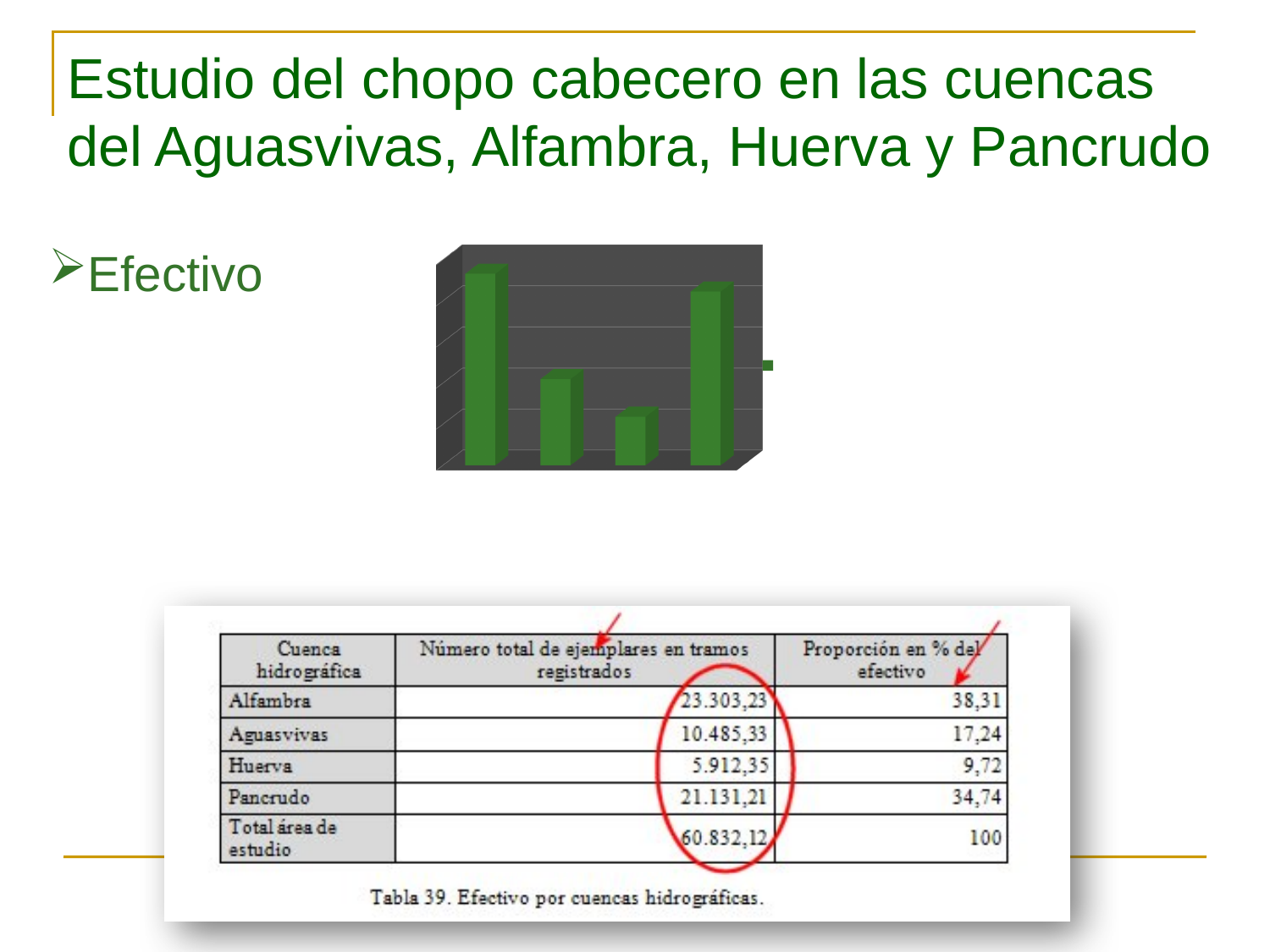
In the chart, is the first bar from the left taller or shorter than the third bar? taller Which bar in the chart is the shortest, counting from the left? the third bar How many bars does the chart show? 4 Does the chart display any axis labels or data labels? No What kind of chart is shown on the slide? bar chart What colour are the bars in the chart? green In the chart, is the second bar from the left taller or shorter than the fourth bar? shorter Which bar in the chart is the tallest, counting from the left? the first bar